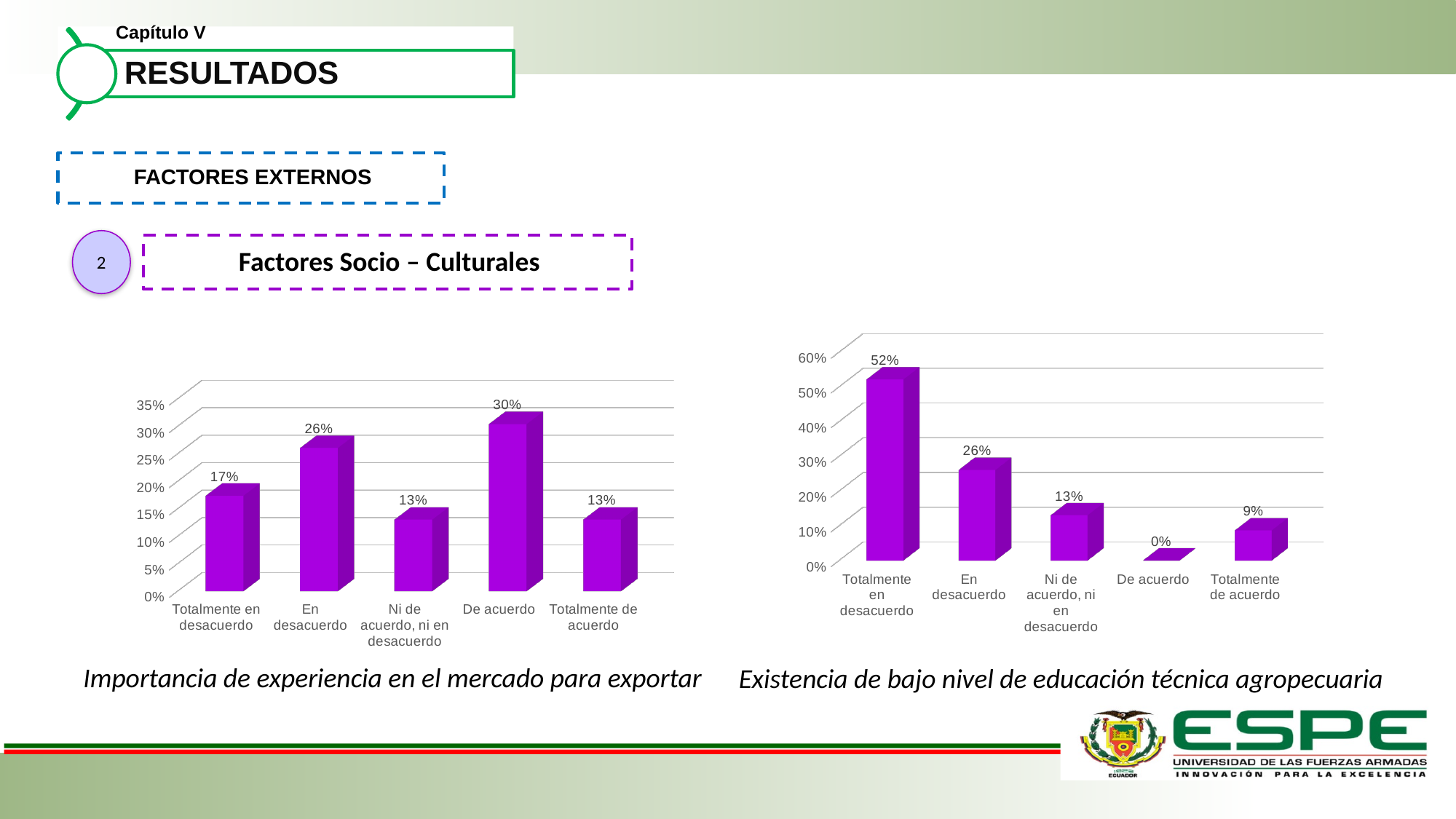
In the left chart (Importancia de experiencia en el mercado para exportar), what is the value for 'De acuerdo'? 30% In the right chart (Existencia de bajo nivel de educación técnica agropecuaria), what is the value for 'Totalmente en desacuerdo'? 52% In the right chart (Existencia de bajo nivel de educación técnica agropecuaria), which category has the lowest value? De acuerdo In the right chart (Existencia de bajo nivel de educación técnica agropecuaria), which is larger: 'Ni de acuerdo, ni en desacuerdo' or 'Totalmente de acuerdo'? Ni de acuerdo, ni en desacuerdo In the right chart (Existencia de bajo nivel de educación técnica agropecuaria), what is the difference between 'Totalmente en desacuerdo' and 'En desacuerdo'? 26% In the left chart (Importancia de experiencia en el mercado para exportar), how many categories are shown? 5 In the left chart (Importancia de experiencia en el mercado para exportar), which category has the highest value? De acuerdo In the left chart (Importancia de experiencia en el mercado para exportar), what is the difference between 'De acuerdo' and 'En desacuerdo'? 4% What type of chart is the right chart (Existencia de bajo nivel de educación técnica agropecuaria)? Bar chart In the right chart (Existencia de bajo nivel de educación técnica agropecuaria), what is the value for 'Totalmente de acuerdo'? 9% In the left chart (Importancia de experiencia en el mercado para exportar), what is the value for 'Totalmente en desacuerdo'? 17% In the right chart (Existencia de bajo nivel de educación técnica agropecuaria), is the value for 'Totalmente en desacuerdo' greater or less than 50%? greater